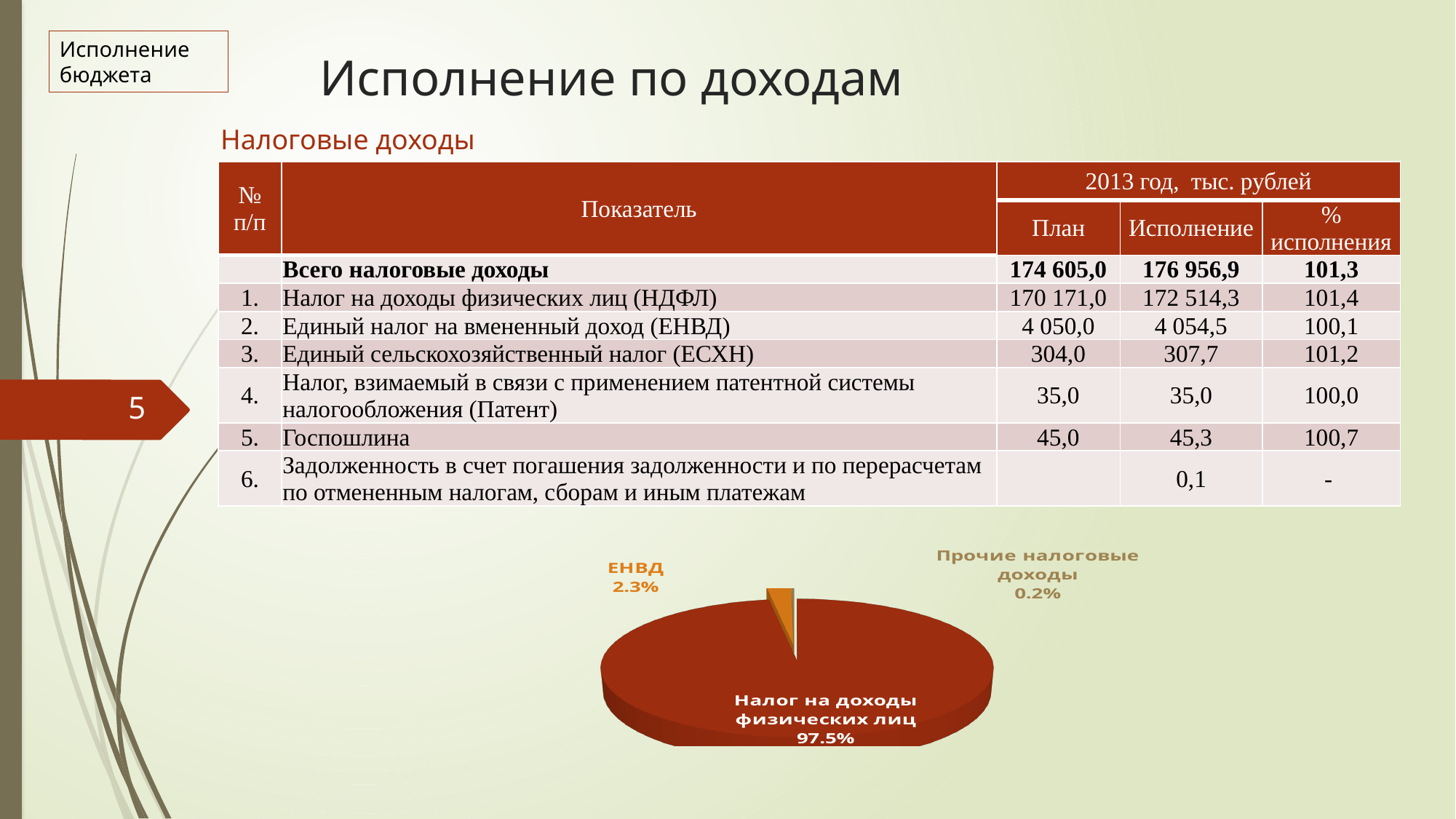
What share of the pie chart is labelled "Налог на доходы физических лиц"? 97.5% What share of the pie chart is labelled "ЕНВД"? 2.3% Which slice of the pie chart is the smallest? Прочие налоговые доходы What share of the pie chart is labelled "Прочие налоговые доходы"? 0.2% In the pie chart, which is larger: ЕНВД or Прочие налоговые доходы? ЕНВД What kind of chart is shown at the bottom of the slide? pie chart In the pie chart, what is the difference in percentage points between the ЕНВД slice and the Прочие налоговые доходы slice? 2.1 Is the share of the ЕНВД slice in the pie chart greater or less than 5%? less How many slices does the pie chart have? 3 In the pie chart, what is the difference in percentage points between the Налог на доходы физических лиц slice and the ЕНВД slice? 95.2 Which slice of the pie chart is the largest? Налог на доходы физических лиц What colour is the largest slice of the pie chart? dark red